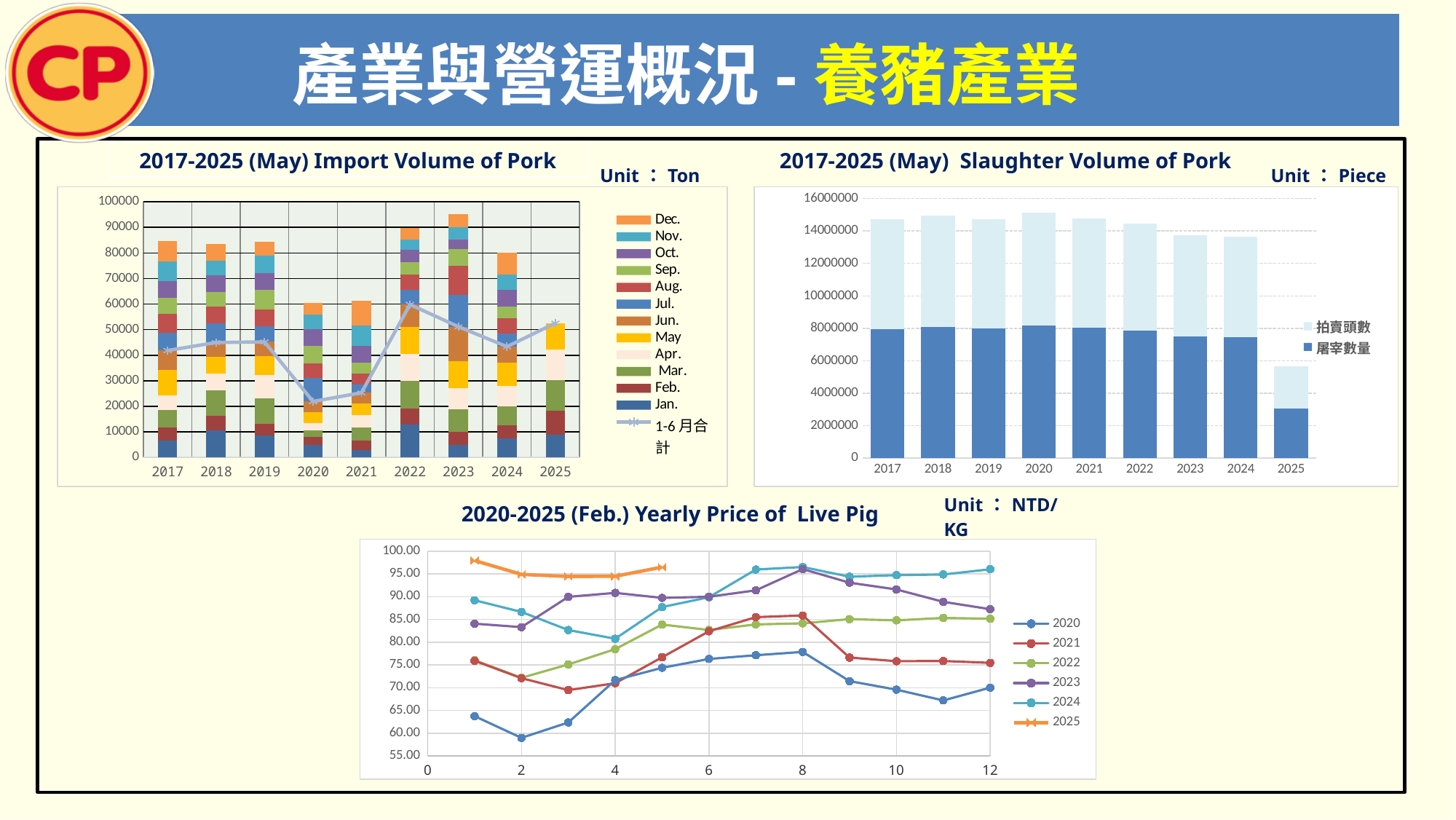
In the "2017-2025 (May) Slaughter Volume of Pork" chart, is the total for 2025 greater or less than 6000000? less In the "2020-2025 (Feb.) Yearly Price of Live Pig" chart, how many series does the legend list? 6 In the "2020-2025 (Feb.) Yearly Price of Live Pig" chart, is the 2020 value at month 2 greater or less than 60.00? less In the "2017-2025 (May) Import Volume of Pork" chart, how many years are shown on the x axis? 9 In the "2017-2025 (May) Slaughter Volume of Pork" chart, is the total for 2017 greater or less than 14000000? greater In the "2017-2025 (May) Slaughter Volume of Pork" chart, which year has the lowest total? 2025 What kind of chart is the "2017-2025 (May) Import Volume of Pork" chart? Stacked bar chart with a line In the "2017-2025 (May) Slaughter Volume of Pork" chart, how many series does the legend list? 2 In the "2017-2025 (May) Import Volume of Pork" chart, which year has the highest total import volume? 2023 In the "2017-2025 (May) Import Volume of Pork" chart, what unit is stated for the values? Ton